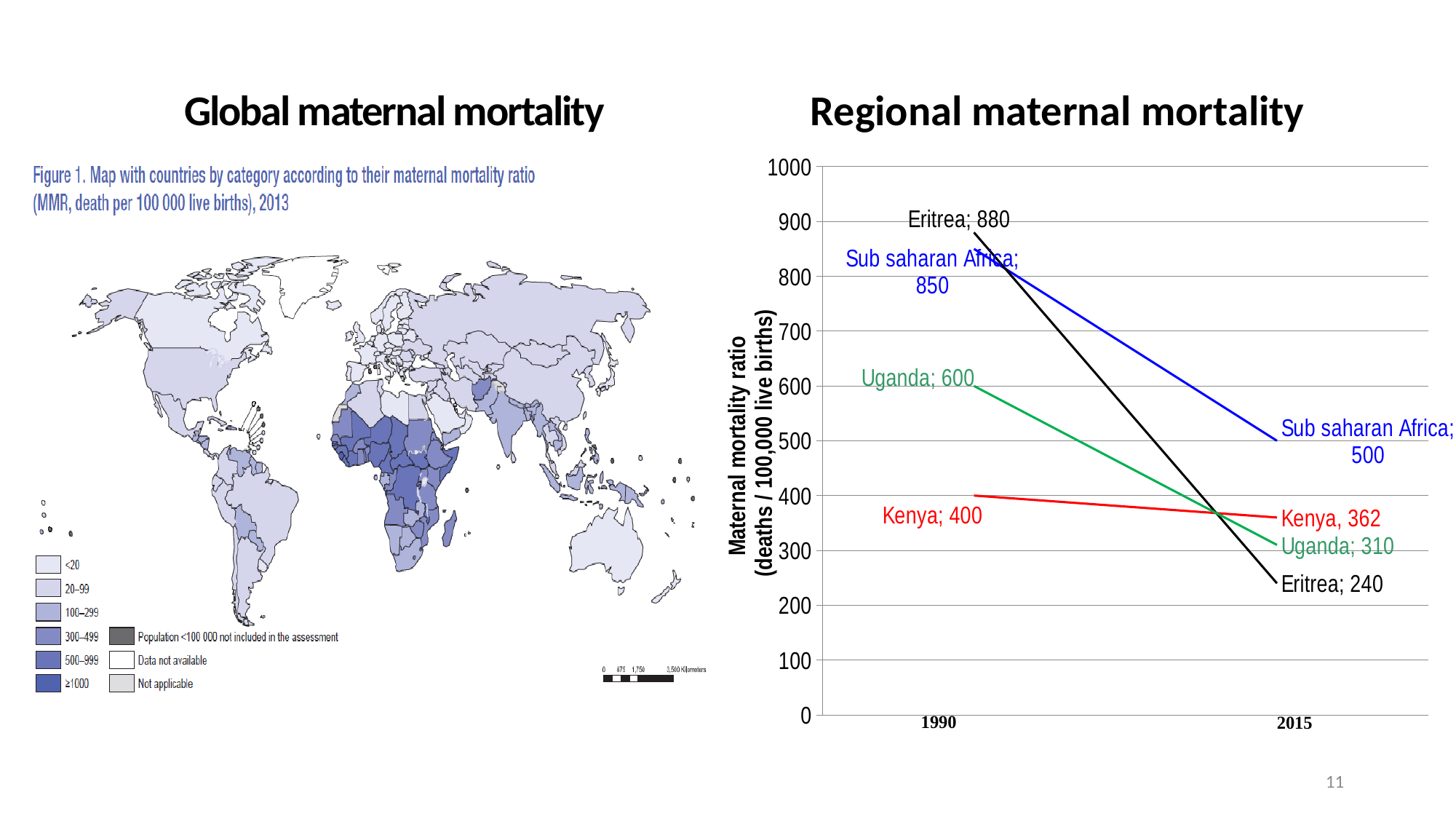
In the Regional maternal mortality chart, what is the difference between Kenya's and Uganda's values in 2015? 52 In the Regional maternal mortality chart, which country or region had the highest maternal mortality ratio in 1990? Eritrea In the Regional maternal mortality chart, how do the values change from 1990 to 2015 for all four series? They fall In the Regional maternal mortality chart, what was the value for Uganda in 2015? 310 In the Regional maternal mortality chart, which was higher in 2015, Kenya or Uganda? Kenya In the Regional maternal mortality chart, what was the maternal mortality ratio for Eritrea in 1990? 880 In the Regional maternal mortality chart, which country or region had the lowest maternal mortality ratio in 2015? Eritrea In the Regional maternal mortality chart, what was the maternal mortality ratio for Sub saharan Africa in 2015? 500 In the Regional maternal mortality chart, what was the value for Kenya in 1990? 400 In the Regional maternal mortality chart, by how much did Eritrea's maternal mortality ratio fall between 1990 and 2015? 640 In the Regional maternal mortality chart, how many years are shown on the x axis? 2 What type of chart is the Regional maternal mortality chart? Line chart